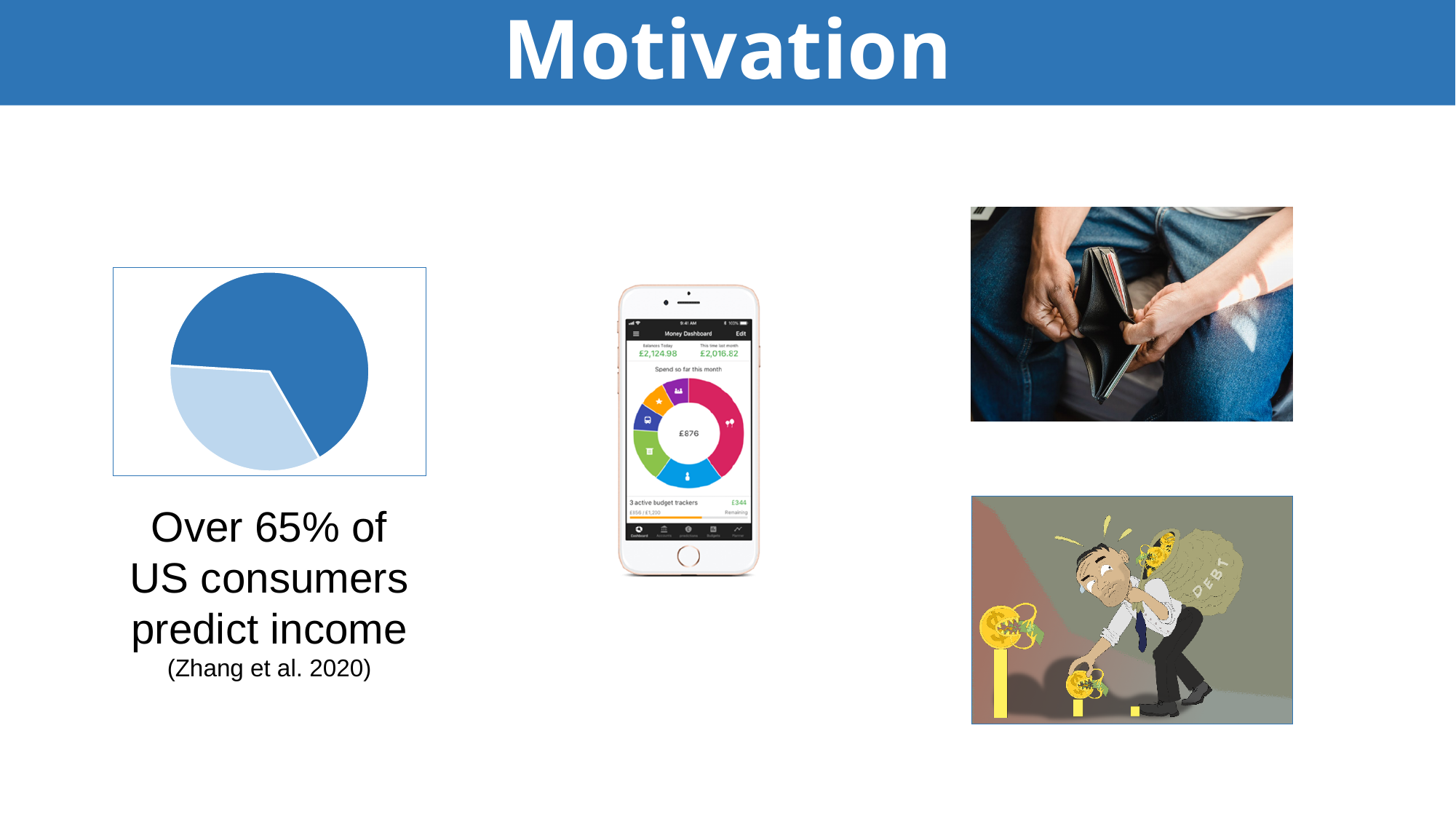
What kind of chart is shown on the left of the slide? pie chart In the pie chart on the left, is the light blue slice's share greater or less than 50%? less In the pie chart on the left, which slice is larger, the dark blue one or the light blue one? dark blue What two colours are used for the slices of the pie chart on the left? dark blue and light blue Does the pie chart on the left have a legend? No How many slices does the pie chart on the left have? 2 In the pie chart on the left, is the dark blue slice's share greater or less than 50%? greater In the pie chart on the left, which slice is the smallest? the light blue slice